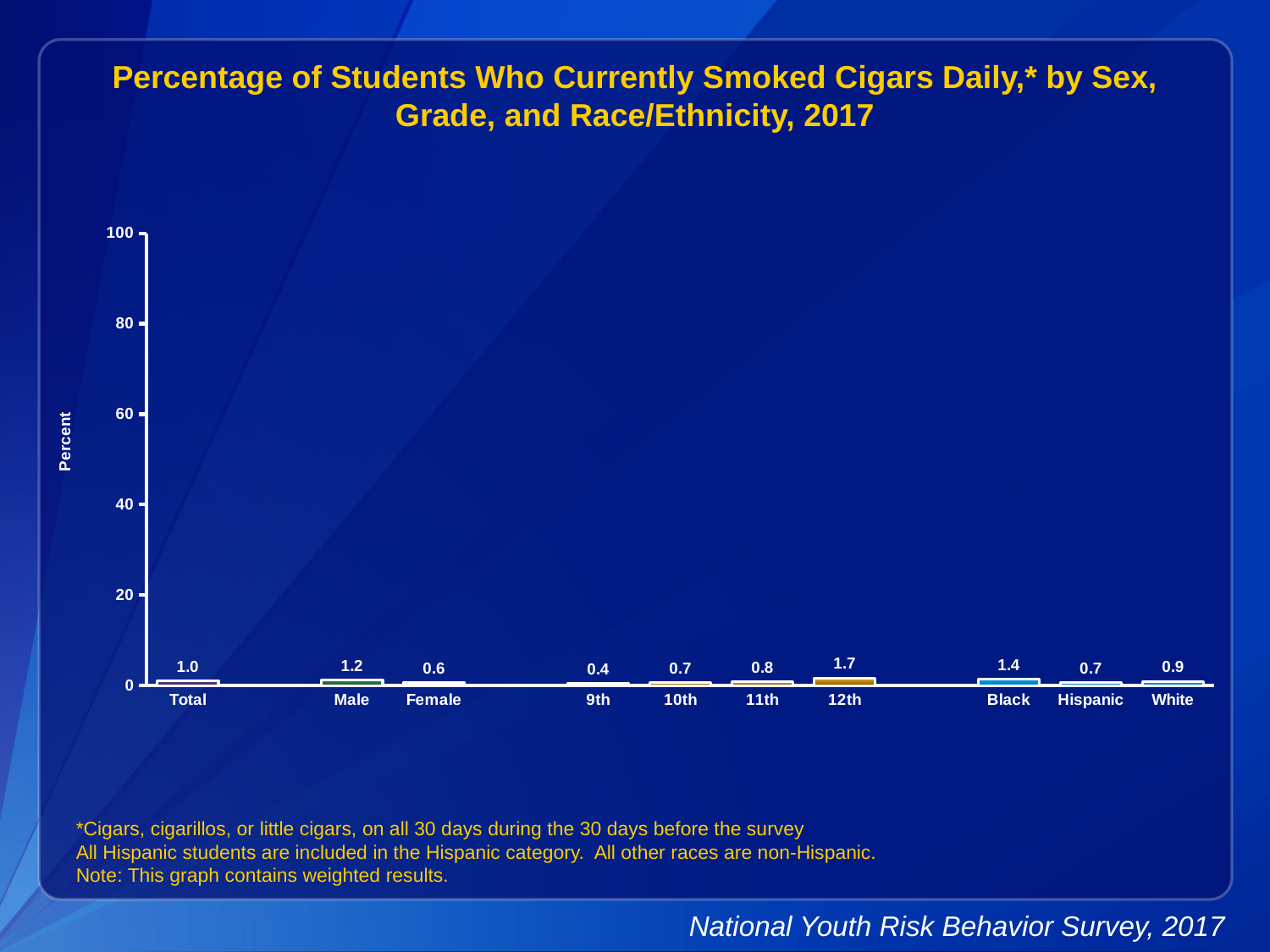
Which category has the lowest value? 9th What is the value for Total? 1.0 How many categories are shown on the x axis? 10 What is the difference between the values for Male and Female? 0.6 What is the value for 12th grade? 1.7 What is the value for Female? 0.6 What kind of chart is shown? bar chart Is the value for 12th grade greater or less than 20? less Which category has the highest value? 12th Do the values rise or fall from 9th grade to 12th grade? rise What is the value for Black students? 1.4 Which is larger, the value for Hispanic or the value for White? White